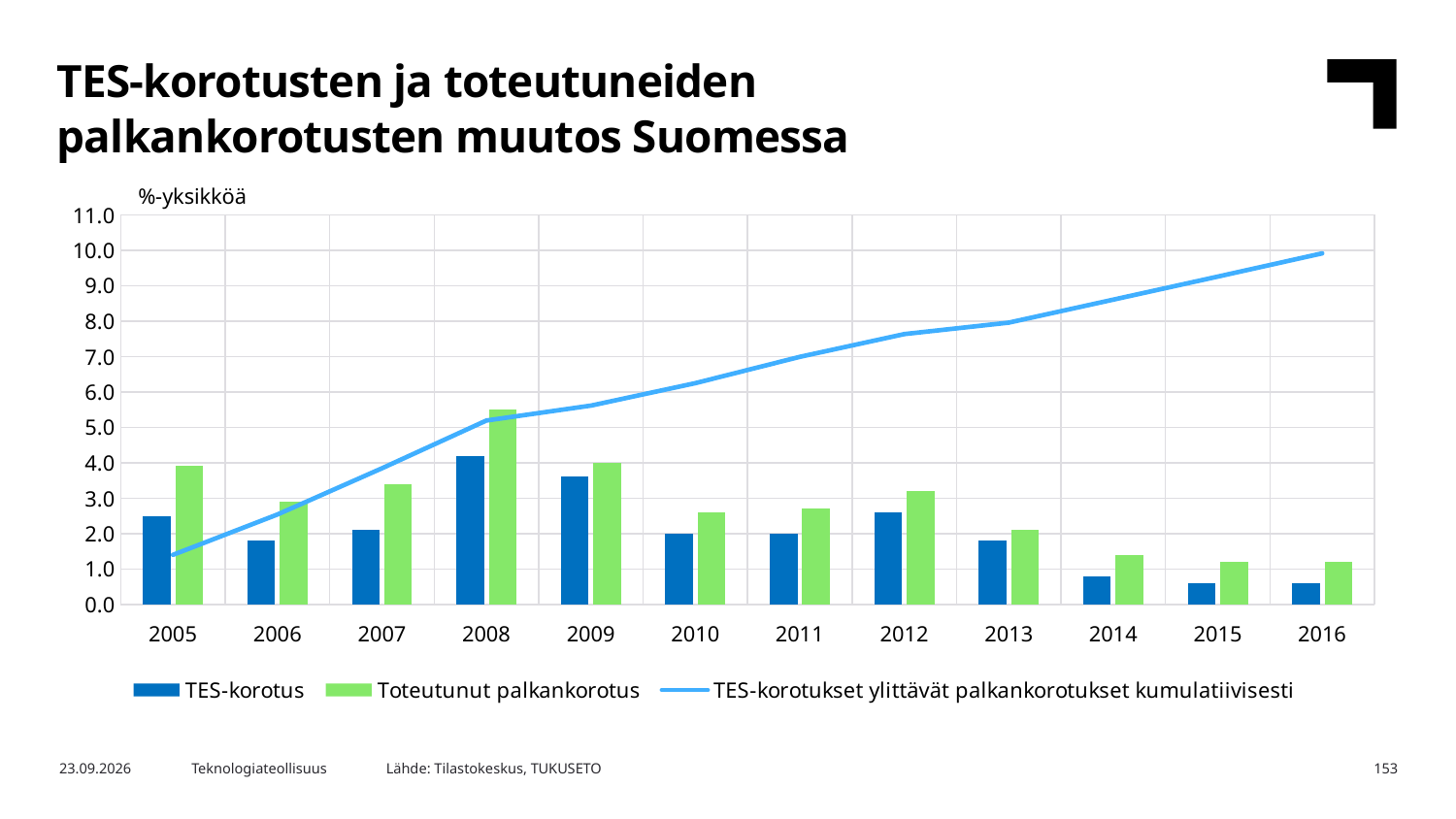
In 2005, which is larger: TES-korotus or Toteutunut palkankorotus? Toteutunut palkankorotus What unit is shown above the y axis? %-yksikköä Is the TES-korotus value for 2014 greater or less than 1.0? less In which year is the TES-korotus bar highest? 2008 Does the line 'TES-korotukset ylittävät palkankorotukset kumulatiivisesti' rise or fall from 2005 to 2016? It rises What kind of chart is shown on the slide? A bar chart combined with a line How many years are shown on the x axis? 12 How many series does the legend list? 3 In which year is the Toteutunut palkankorotus bar highest? 2008 Is the Toteutunut palkankorotus value for 2008 greater or less than 5.0? greater Is the value of the cumulative line in 2016 greater or less than 9.0? greater